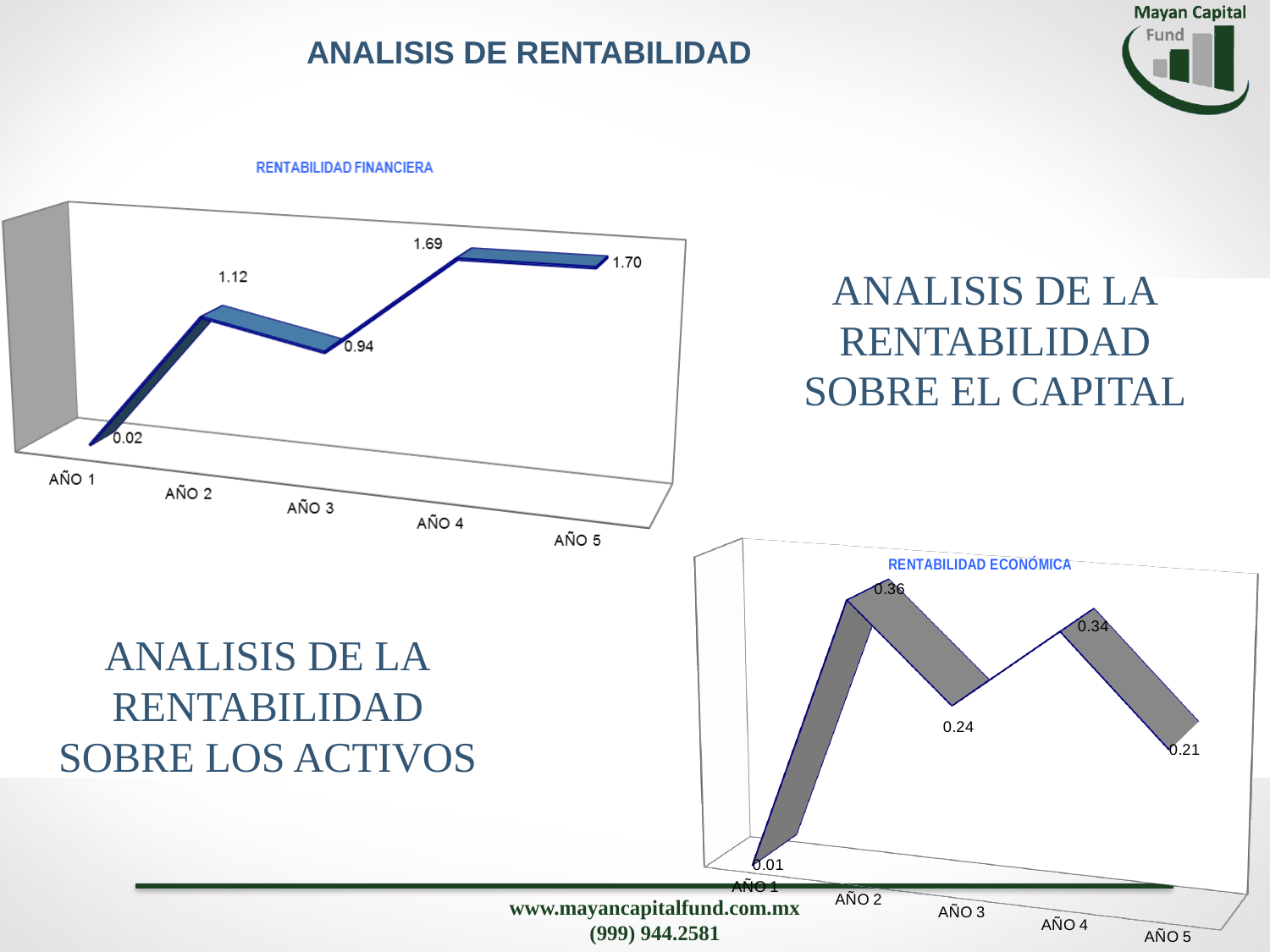
What kind of chart is the RENTABILIDAD FINANCIERA chart? Line chart In the RENTABILIDAD ECONÓMICA chart, what is the value for AÑO 3? 0.24 In the RENTABILIDAD FINANCIERA chart, does the value rise or fall from AÑO 1 to AÑO 2? Rise In the RENTABILIDAD FINANCIERA chart, what is the value for AÑO 2? 1.12 In the RENTABILIDAD ECONÓMICA chart, what is the value for AÑO 5? 0.21 In the RENTABILIDAD ECONÓMICA chart, which year has the lowest value? AÑO 1 In the RENTABILIDAD ECONÓMICA chart, which is larger, the value for AÑO 2 or AÑO 3? AÑO 2 In the RENTABILIDAD FINANCIERA chart, which year has the lowest value? AÑO 1 In the RENTABILIDAD FINANCIERA chart, what is the difference between the values for AÑO 2 and AÑO 3? 0.18 In the RENTABILIDAD FINANCIERA chart, what is the value for AÑO 4? 1.69 In the RENTABILIDAD ECONÓMICA chart, what is the difference between the values for AÑO 2 and AÑO 5? 0.15 In the RENTABILIDAD FINANCIERA chart, how many years are plotted? 5